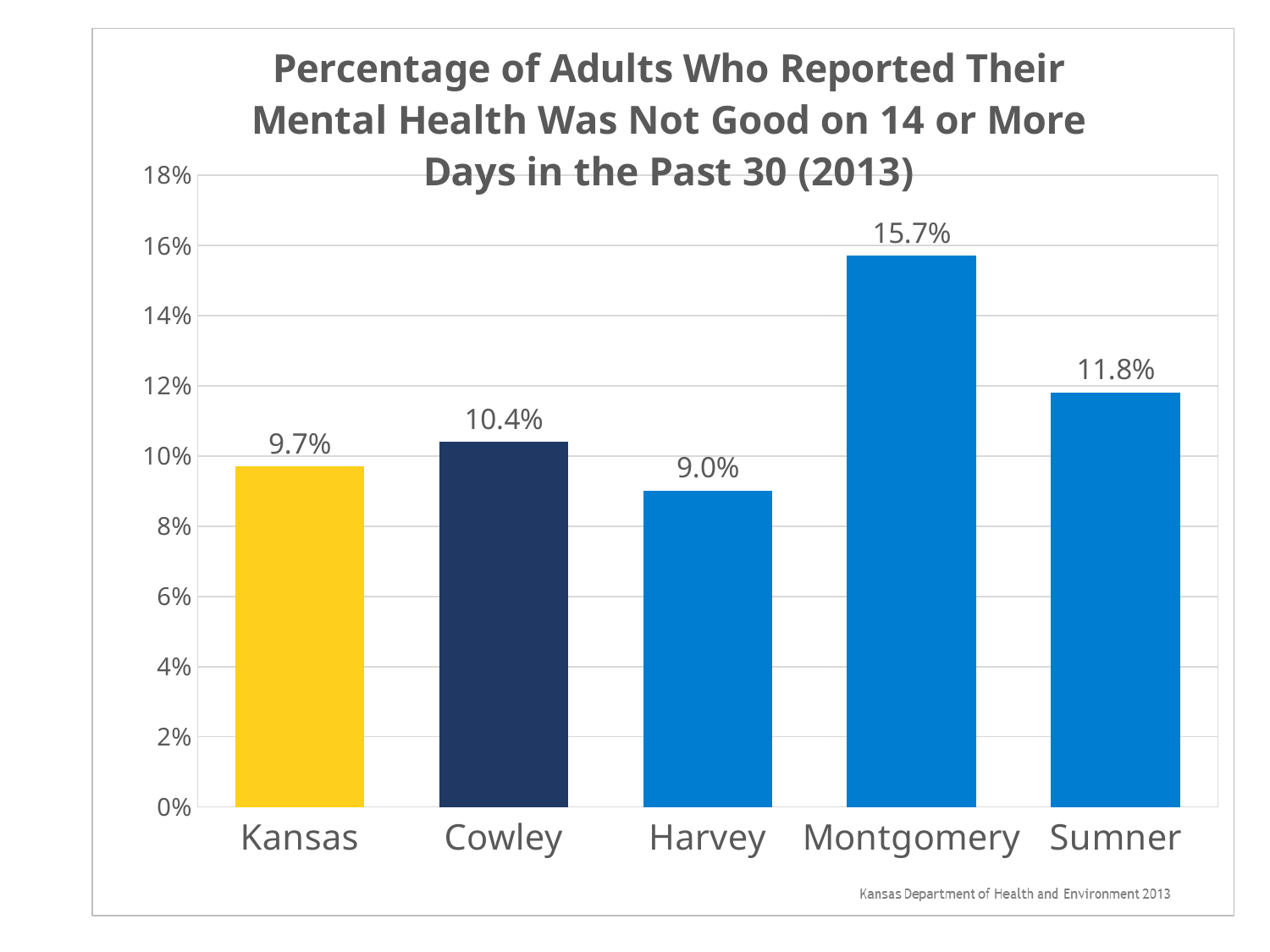
Which is larger, the value for Sumner or the value for Cowley? Sumner What kind of chart is shown on the slide? bar chart What is the difference between the values for Montgomery and Sumner? 3.9% How many categories are shown on the x axis? 5 What colour is the bar for Kansas? yellow What is the value for Harvey? 9.0% Which category has the lowest value? Harvey What is the value for Montgomery? 15.7% What is the difference between the values for Cowley and Kansas? 0.7% Is the value for Montgomery greater or less than 14%? greater Which category has the highest value? Montgomery What is the value for Kansas? 9.7%